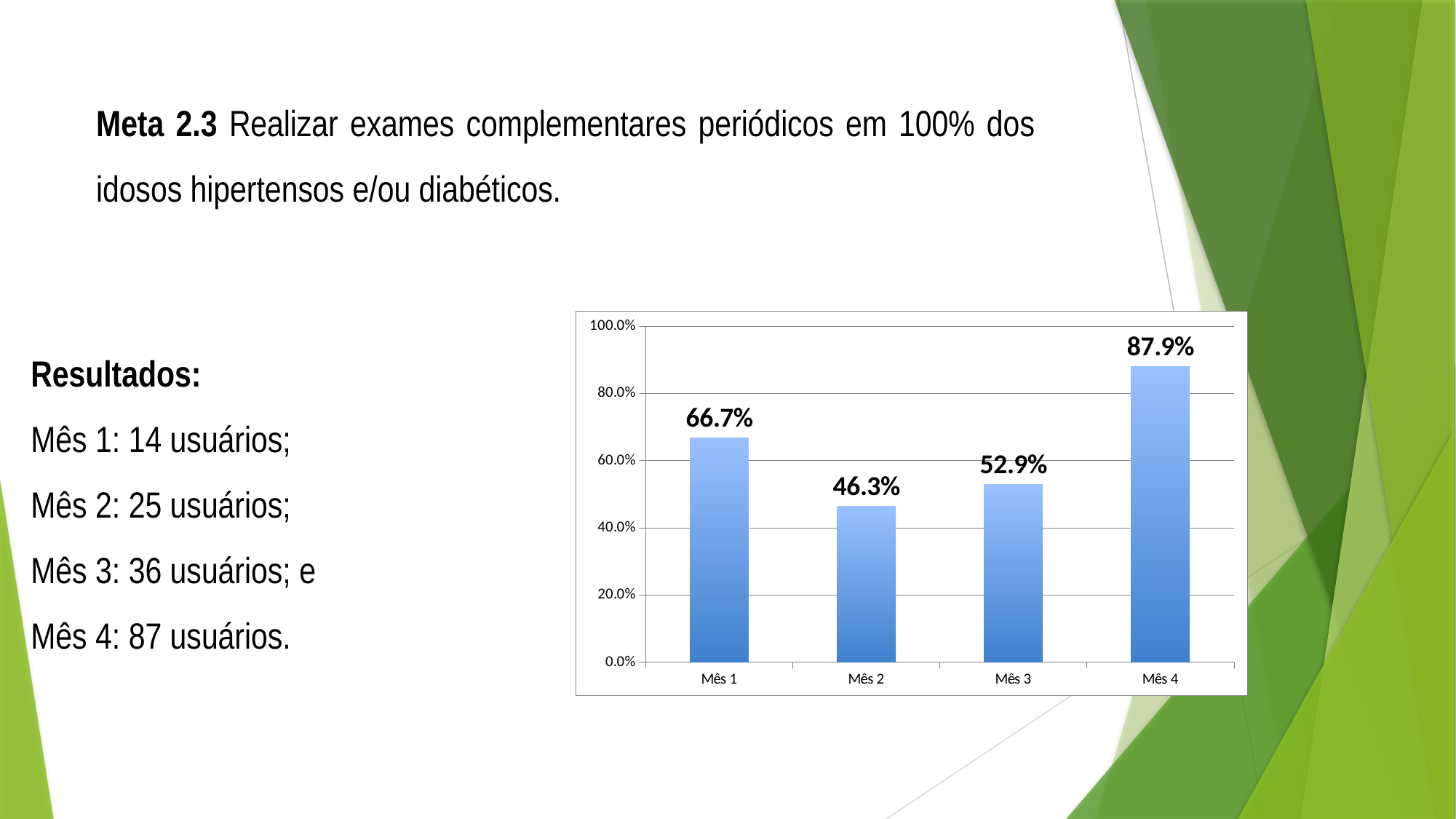
What is the value for Mês 1? 66.7% What is the difference between the values for Mês 3 and Mês 2? 6.6% What is the value for Mês 4? 87.9% What is the difference between the values for Mês 4 and Mês 1? 21.2% What kind of chart is shown on the slide? bar chart Which month has the lowest value? Mês 2 What is the value for Mês 2? 46.3% How many months are shown on the x axis? 4 What is the value for Mês 3? 52.9% Which month has the highest value? Mês 4 Which is larger, the value for Mês 1 or the value for Mês 3? Mês 1 Is the value for Mês 2 greater or less than 60.0%? less